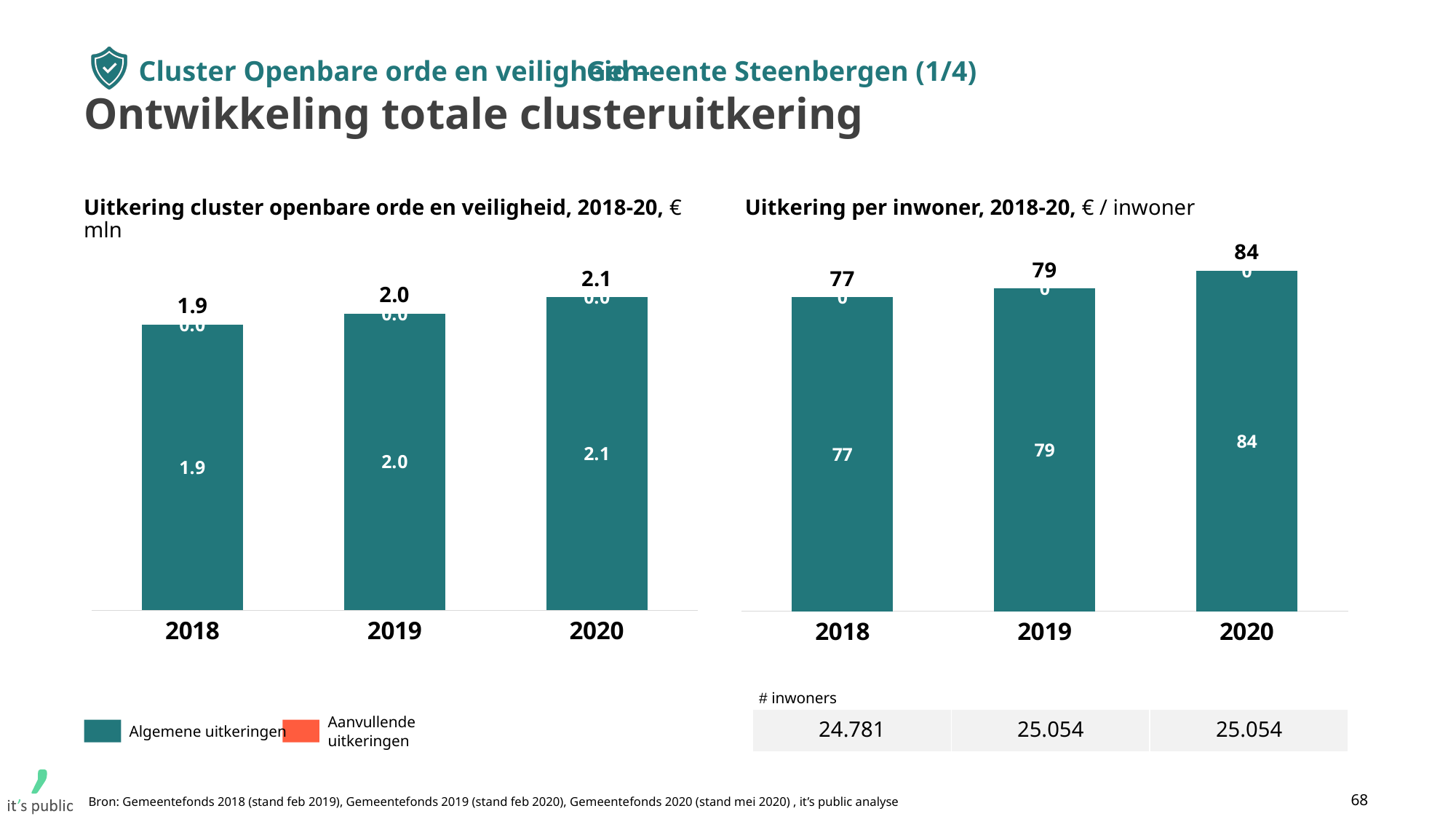
In the chart 'Uitkering per inwoner, 2018-20', which is larger, the value for 2019 or the value for 2020? 2020 In the chart 'Uitkering cluster openbare orde en veiligheid, 2018-20', what is the value of Algemene uitkeringen for 2019? 2.0 In the chart 'Uitkering cluster openbare orde en veiligheid, 2018-20', which year has the highest total? 2020 In the chart 'Uitkering per inwoner, 2018-20', which year has the lowest value? 2018 In the chart 'Uitkering per inwoner, 2018-20', what is the difference between the values for 2020 and 2018? 7 In the chart 'Uitkering cluster openbare orde en veiligheid, 2018-20', do the totals rise or fall from 2018 to 2020? rise How many years are shown on the x axis of the chart 'Uitkering per inwoner, 2018-20'? 3 In the chart 'Uitkering cluster openbare orde en veiligheid, 2018-20', what is the total value for 2020? 2.1 How many series does the legend of the chart 'Uitkering cluster openbare orde en veiligheid, 2018-20' list? 2 What kind of chart is 'Uitkering per inwoner, 2018-20'? bar chart In the chart 'Uitkering per inwoner, 2018-20', what is the value for 2019? 79 In the chart 'Uitkering cluster openbare orde en veiligheid, 2018-20', what is the total value for 2018? 1.9